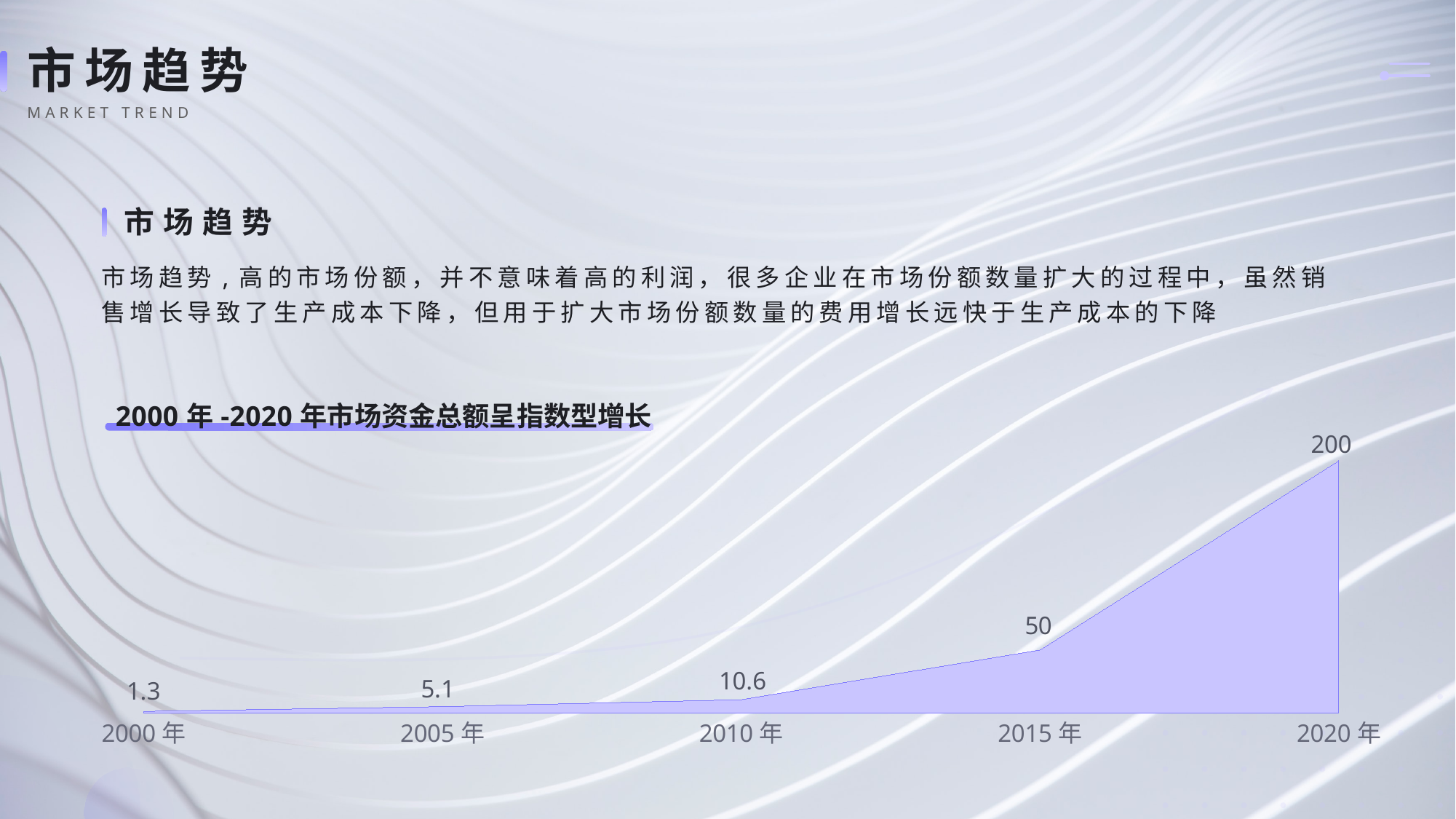
What is the difference between the values for 2005 年 and 2000 年? 3.8 What is the value for 2010 年? 10.6 Which year has the highest value? 2020 年 What is the value for 2020 年? 200 What is the value for 2000 年? 1.3 What is the difference between the values for 2020 年 and 2015 年? 150 Which is larger, the value for 2010 年 or the value for 2005 年? 2010 年 Which year has the lowest value? 2000 年 What is the value for 2015 年? 50 Do the values rise or fall from 2000 年 to 2020 年? rise What kind of chart is shown? area chart How many years are plotted on the chart? 5